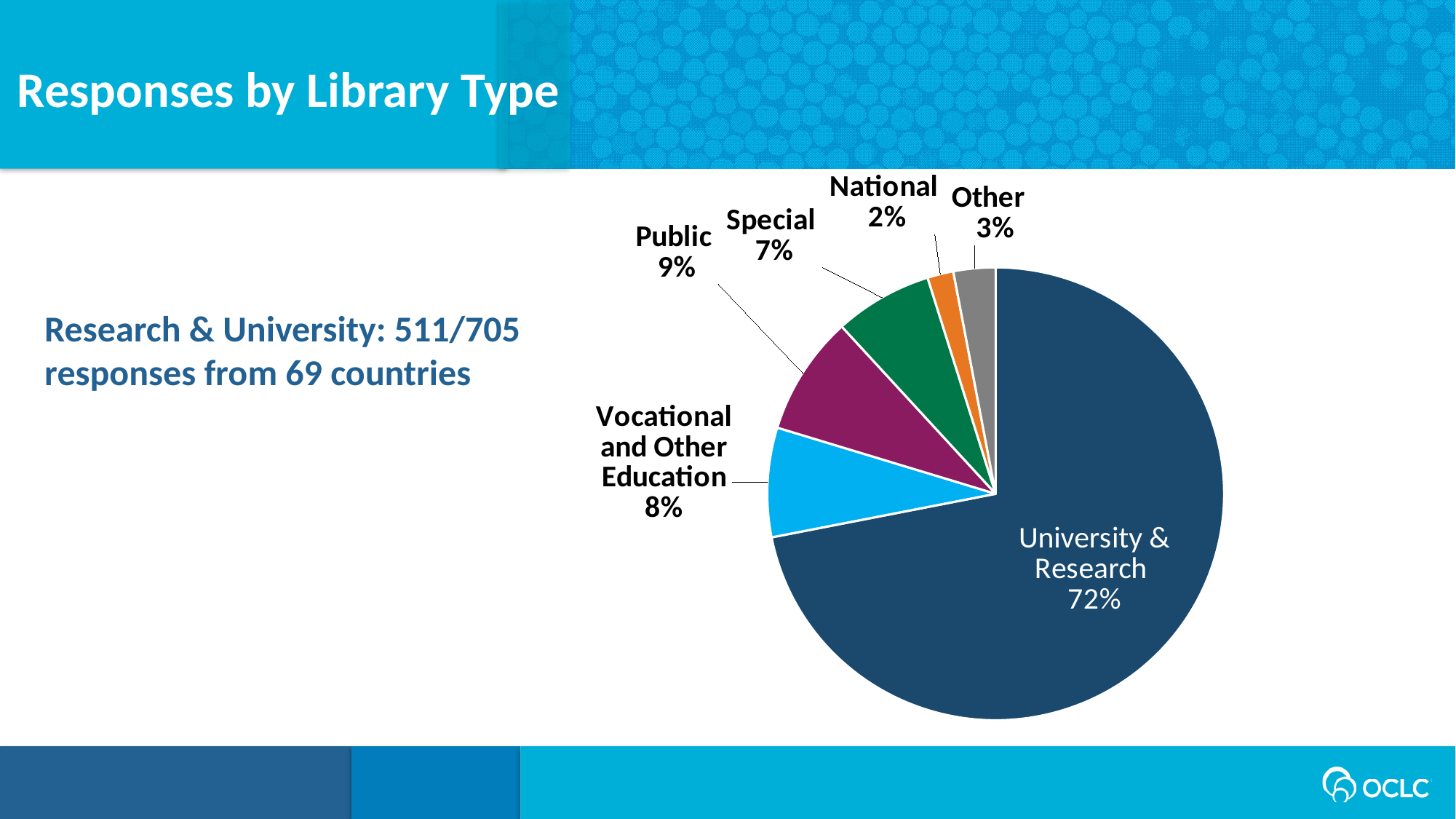
What share of responses came from Public libraries? 9% What share of responses came from Special libraries? 7% What share of responses came from National libraries? 2% Which library type has the smallest share of responses? National What kind of chart is shown on the slide? Pie chart What is the difference in percentage points between the Public and Special shares? 2% What is the title of the slide containing the chart? Responses by Library Type How many library types are shown in the pie chart? 6 Which library type has the largest share of responses? University & Research Which has a larger share, Other or National? Other